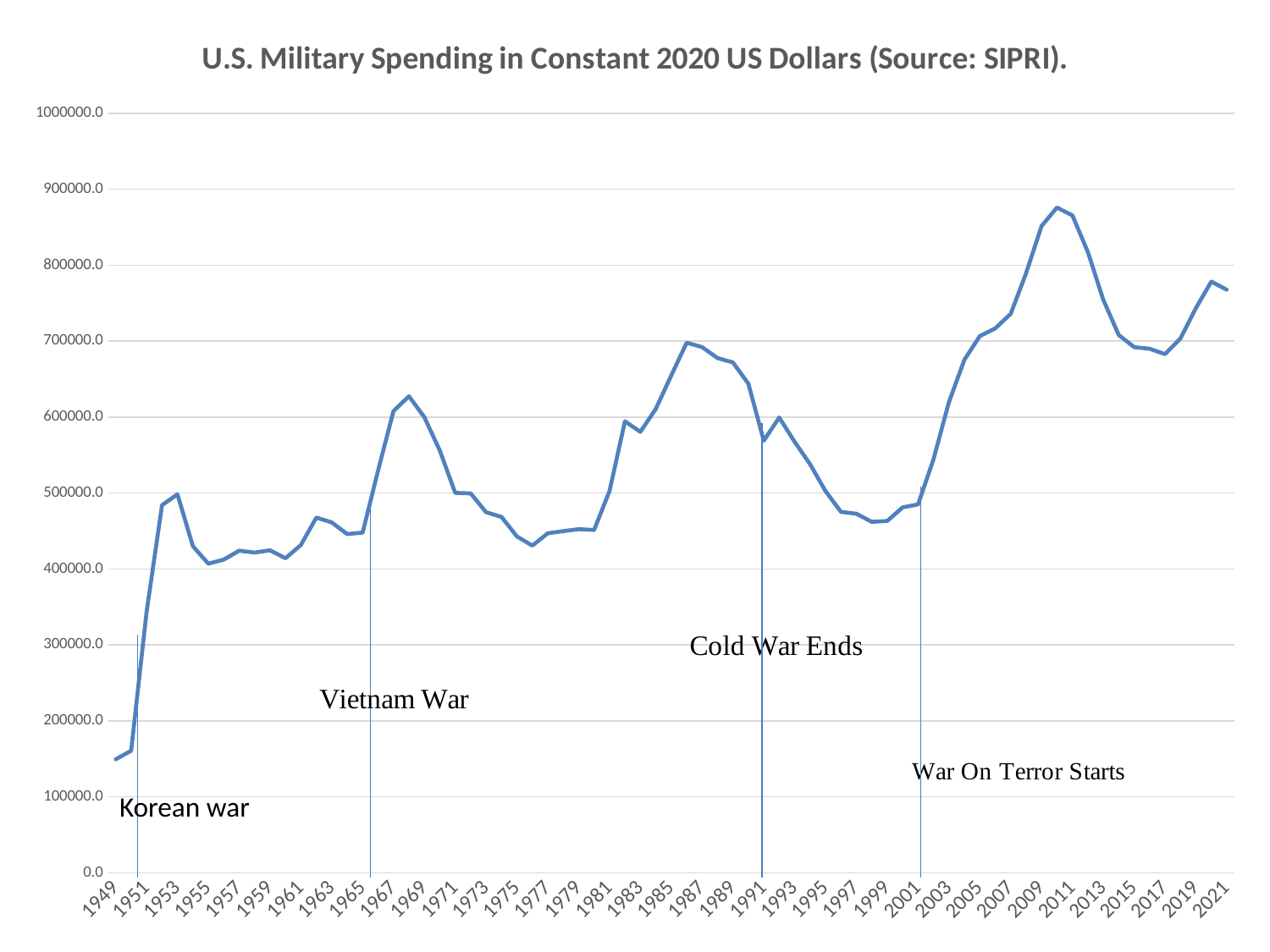
What is the title of the chart? U.S. Military Spending in Constant 2020 US Dollars (Source: SIPRI). Is the value for 1949 greater or less than 200000.0? less Is the value for 1976 greater or less than 500000.0? less What kind of chart is shown on the slide? line chart Which year has the lowest military spending value on the chart? 1949 Does military spending rise or fall between 1986 and 1998? fall Is the value for 2020 greater or less than 700000.0? greater Which year has the larger value, 1953 or 2010? 2010 Which event is annotated on the chart at the year 2001? War On Terror Starts Which year has the larger value, 1968 or 1986? 1986